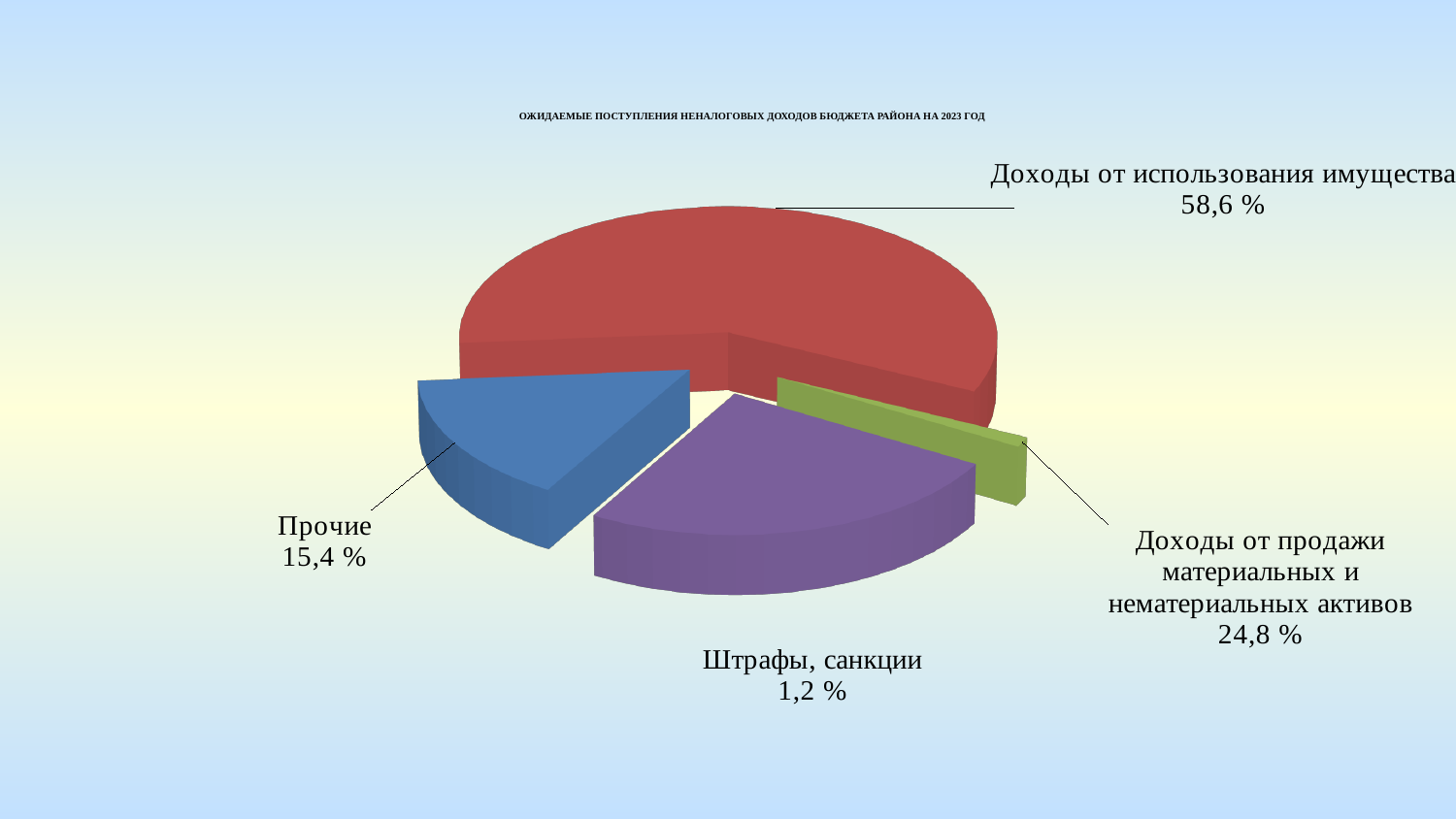
How many categories are shown in the pie chart? 4 Which category has the smallest share of the pie? Штрафы, санкции Which is larger: the share of Прочие or the share of Доходы от продажи материальных и нематериальных активов? Доходы от продажи материальных и нематериальных активов What is the value shown for Доходы от использования имущества? 58,6 % What is the title of the chart? ОЖИДАЕМЫЕ ПОСТУПЛЕНИЯ НЕНАЛОГОВЫХ ДОХОДОВ БЮДЖЕТА РАЙОНА НА 2023 ГОД What is the value shown for Доходы от продажи материальных и нематериальных активов? 24,8 % What kind of chart is shown on the slide? Pie chart What is the difference between the shares of Доходы от использования имущества and Доходы от продажи материальных и нематериальных активов? 33,8 % What is the value shown for Прочие? 15,4 % Which category has the largest share of the pie? Доходы от использования имущества What is the difference between the shares of Прочие and Штрафы, санкции? 14,2 % What is the value shown for Штрафы, санкции? 1,2 %